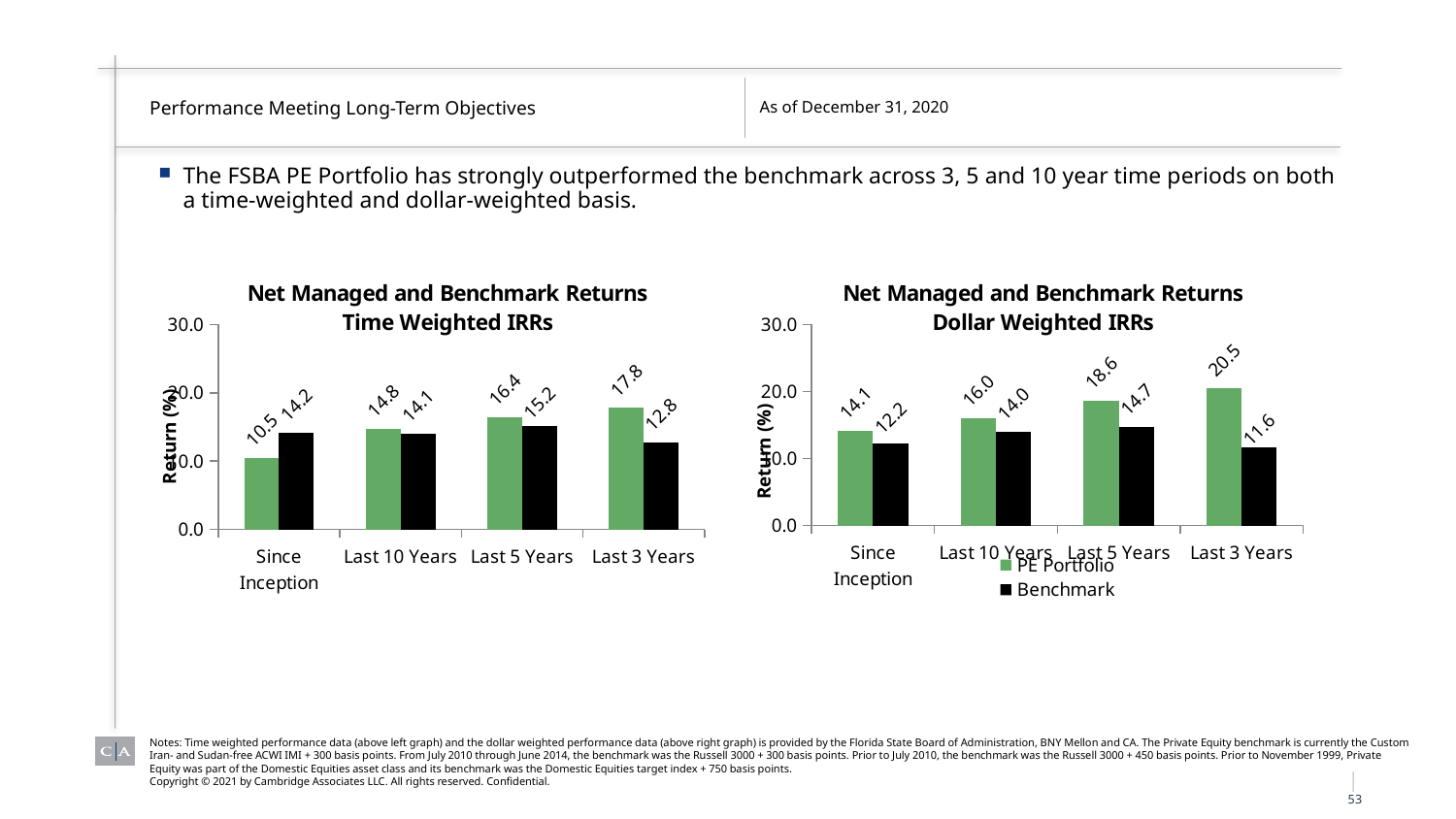
In the Dollar Weighted IRRs chart, is the PE Portfolio value for Last 3 Years greater or less than 20.0? greater How many series does the legend of the Dollar Weighted IRRs chart list? 2 In the Dollar Weighted IRRs chart, what is the difference between the PE Portfolio and Benchmark values for Last 3 Years? 8.9 How many time periods are shown on the x axis of the Dollar Weighted IRRs chart? 4 What type of chart is the Time Weighted IRRs chart? bar chart In the Dollar Weighted IRRs chart, what is the PE Portfolio value for Last 5 Years? 18.6 In the Time Weighted IRRs chart, which period has the lowest green bar value? Since Inception In the Time Weighted IRRs chart, which is larger for Since Inception, the green bar or the black bar? the black bar In the Dollar Weighted IRRs chart, which period has the highest PE Portfolio value? Last 3 Years In the Time Weighted IRRs chart, what is the value of the green bar for Last 3 Years? 17.8 In the Dollar Weighted IRRs chart, what is the Benchmark value for Last 3 Years? 11.6 In the Time Weighted IRRs chart, what is the value of the black bar for Since Inception? 14.2